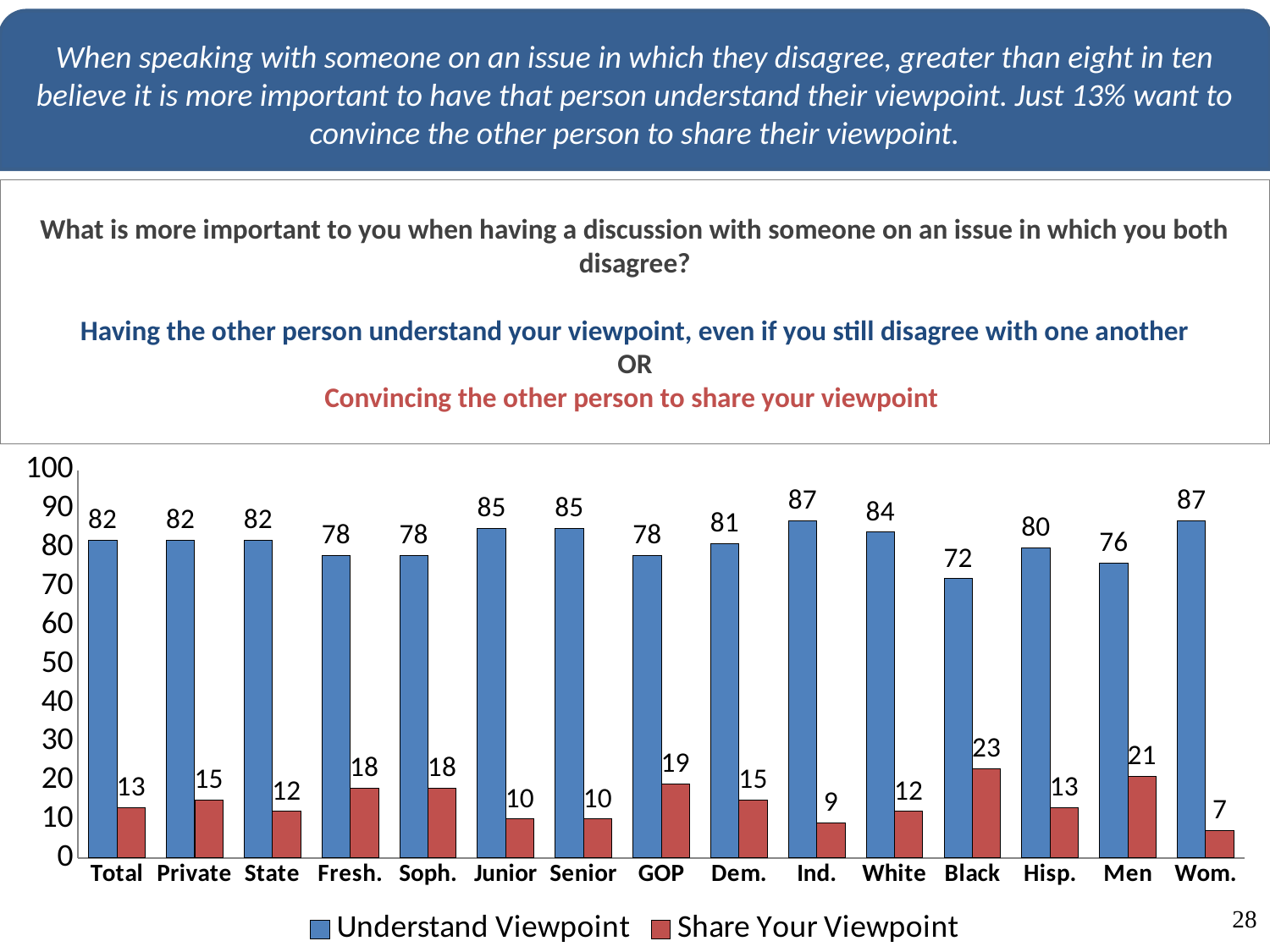
What kind of chart is shown on the slide? Bar chart What is the value for Understand Viewpoint for Dem.? 81 What is the difference between the Understand Viewpoint and Share Your Viewpoint values for Total? 69 What colour are the Share Your Viewpoint bars? Red Which category has the highest Share Your Viewpoint value? Black Which category has the lowest Understand Viewpoint value? Black How many categories are shown on the x axis? 15 Which category has the lowest Share Your Viewpoint value? Wom. What is the value for Understand Viewpoint for Black? 72 Which is larger, the Share Your Viewpoint value for GOP or for Ind.? GOP How many series does the legend list? 2 What is the value for Share Your Viewpoint for Men? 21